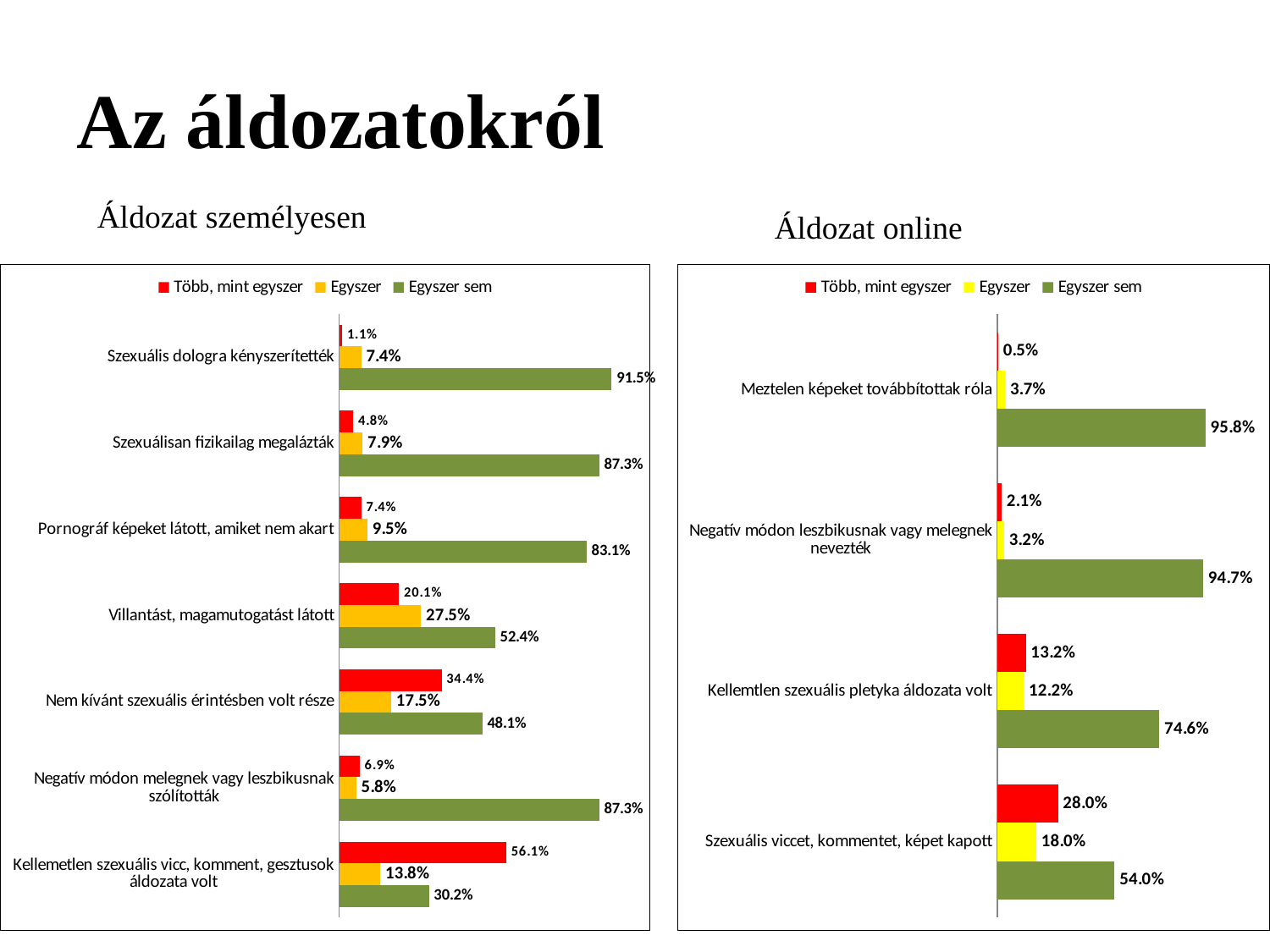
In the 'Áldozat személyesen' chart, what is the difference between the 'Több, mint egyszer' and 'Egyszer' values for 'Nem kívánt szexuális érintésben volt része'? 16.9% In the 'Áldozat online' chart, is the 'Több, mint egyszer' value for 'Kellemtlen szexuális pletyka áldozata volt' larger or smaller than its 'Egyszer' value? larger In the 'Áldozat online' chart, what is the 'Egyszer sem' value for 'Meztelen képeket továbbítottak róla'? 95.8% In the 'Áldozat személyesen' chart, what is the 'Egyszer sem' value for 'Szexuális dologra kényszerítették'? 91.5% What type of chart is the 'Áldozat online' chart? bar chart In the 'Áldozat online' chart, which category has the highest 'Több, mint egyszer' value? Szexuális viccet, kommentet, képet kapott In the 'Áldozat személyesen' chart, what is the 'Több, mint egyszer' value for 'Kellemetlen szexuális vicc, komment, gesztusok áldozata volt'? 56.1% How many series does the legend of the 'Áldozat online' chart list? 3 In the 'Áldozat személyesen' chart, how many categories are shown? 7 In the 'Áldozat online' chart, what is the 'Egyszer' value for 'Szexuális viccet, kommentet, képet kapott'? 18.0% In the 'Áldozat személyesen' chart, which category has the highest 'Egyszer' value? Villantást, magamutogatást látott In the 'Áldozat személyesen' chart, which category has the lowest 'Egyszer sem' value? Kellemetlen szexuális vicc, komment, gesztusok áldozata volt